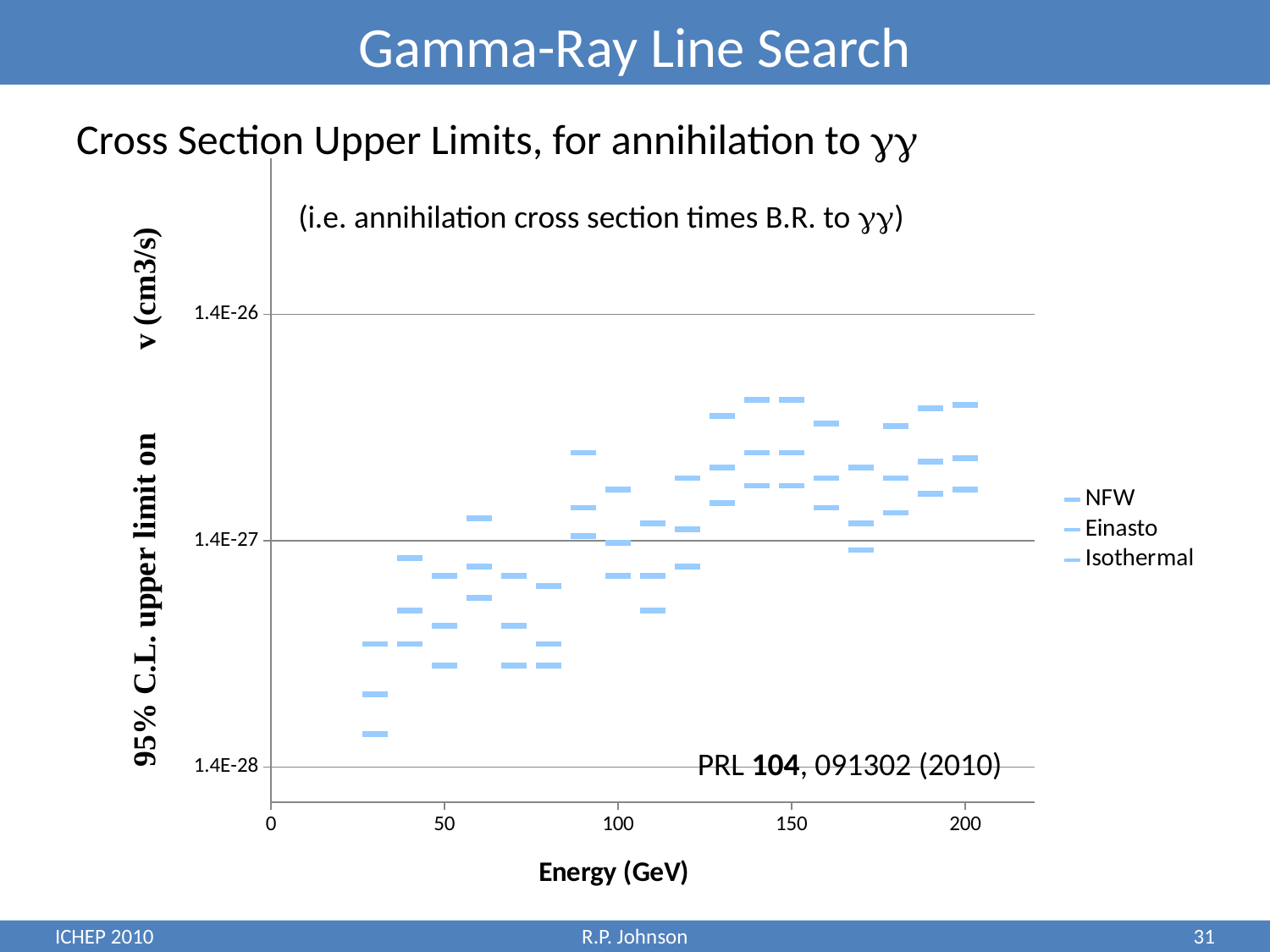
What is the title of the chart's x axis? Energy (GeV) Is the highest plotted value on the chart greater or less than 1.4E-26? less Are the plotted values at 200 GeV higher or lower than those at 30 GeV? higher Is the lowest plotted value on the chart greater or less than 1.4E-28? greater Are the plotted values at the lowest energy (around 30 GeV) greater or less than 1.4E-27? less How many series does the chart legend list? 3 Do the plotted upper limits generally rise or fall as energy increases along the x axis? rise How many distinct energy values have points plotted on the chart? 18 What are the three series named in the chart legend? NFW, Einasto, Isothermal What kind of chart is shown on the slide? scatter chart